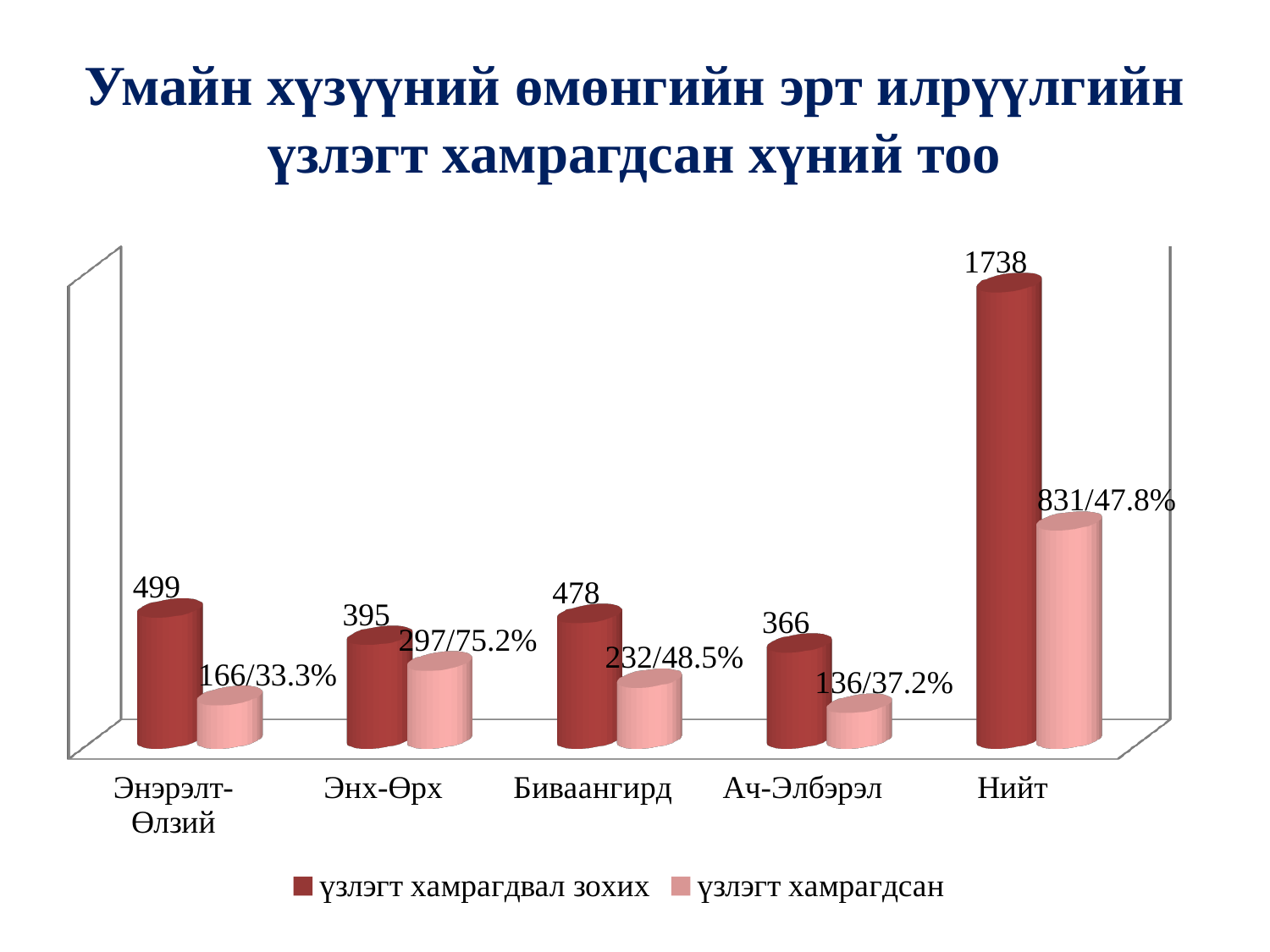
How many categories are shown on the x axis? 5 Excluding Нийт, which category has the highest "үзлэгт хамрагдвал зохих" value? Энэрэлт-Өлзий Excluding Нийт, which category has the lowest "үзлэгт хамрагдсан" value? Ач-Элбэрэл What is the value of "үзлэгт хамрагдвал зохих" for Нийт? 1738 What is the difference between the "үзлэгт хамрагдвал зохих" and "үзлэгт хамрагдсан" values for Биваангирд? 246 What data label is shown on the "үзлэгт хамрагдсан" bar for Ач-Элбэрэл? 136/37.2% What is the value of "үзлэгт хамрагдвал зохих" for Энэрэлт-Өлзий? 499 What is the title of the chart on the slide? Умайн хүзүүний өмөнгийн эрт илрүүлгийн үзлэгт хамрагдсан хүний тоо How many series does the legend list? 2 What data label is shown on the "үзлэгт хамрагдсан" bar for Энх-Өрх? 297/75.2% What kind of chart is shown on the slide? Bar chart Which is larger: the "үзлэгт хамрагдсан" value for Энх-Өрх or for Биваангирд? Энх-Өрх